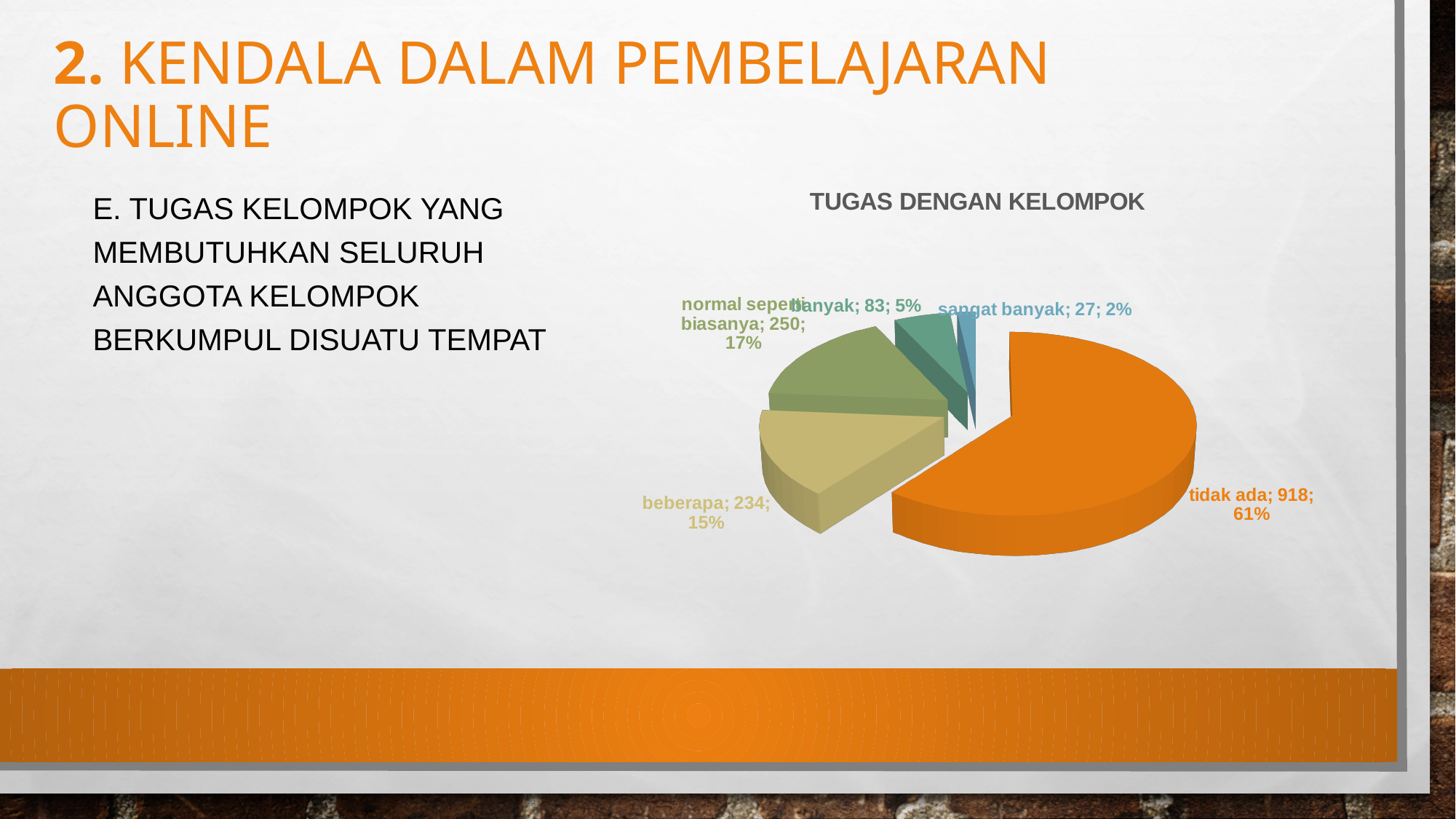
What is the value for "beberapa"? 234 What is the value for "tidak ada"? 918 Which category has the largest slice? tidak ada What is the difference between the values for "normal seperti biasanya" and "beberapa"? 16 How many slices does the pie chart have? 5 Which category has the smallest slice? sangat banyak What share of the pie does "banyak" represent? 5% What is the value for "normal seperti biasanya"? 250 What share of the pie does "tidak ada" represent? 61% What is the value for "sangat banyak"? 27 What kind of chart is shown on the slide? pie chart What is the title of the chart? TUGAS DENGAN KELOMPOK